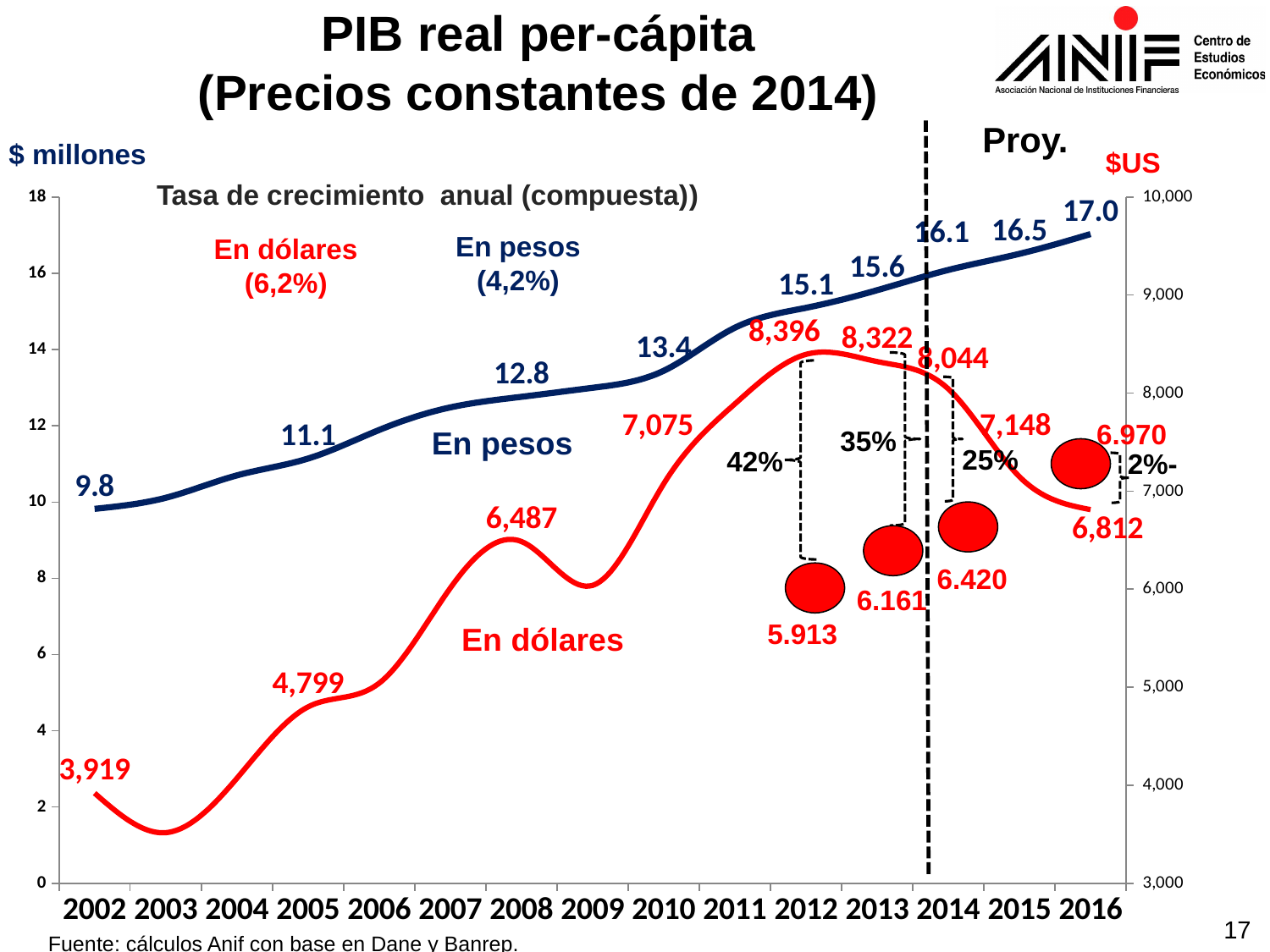
How many years are shown on the x axis? 15 Which is larger for the 'En dólares' series: the 2008 value or the 2010 value? 2010 Does the 'En pesos' series rise or fall from 2002 to 2016? rise What type of chart is shown on the slide? line chart What is the value of the 'En pesos' series in 2002? 9.8 What is the value of the 'En pesos' series in 2016? 17.0 What is the unit label of the right-hand axis? $US What compound annual growth rate is given for the 'En dólares' series? 6,2% What is the value of the 'En dólares' series in 2002? 3,919 What is the value of the 'En dólares' series in 2012? 8,396 What is the difference between the 'En pesos' values for 2016 and 2002? 7.2 In which year does the 'En dólares' series reach its highest labelled value? 2012